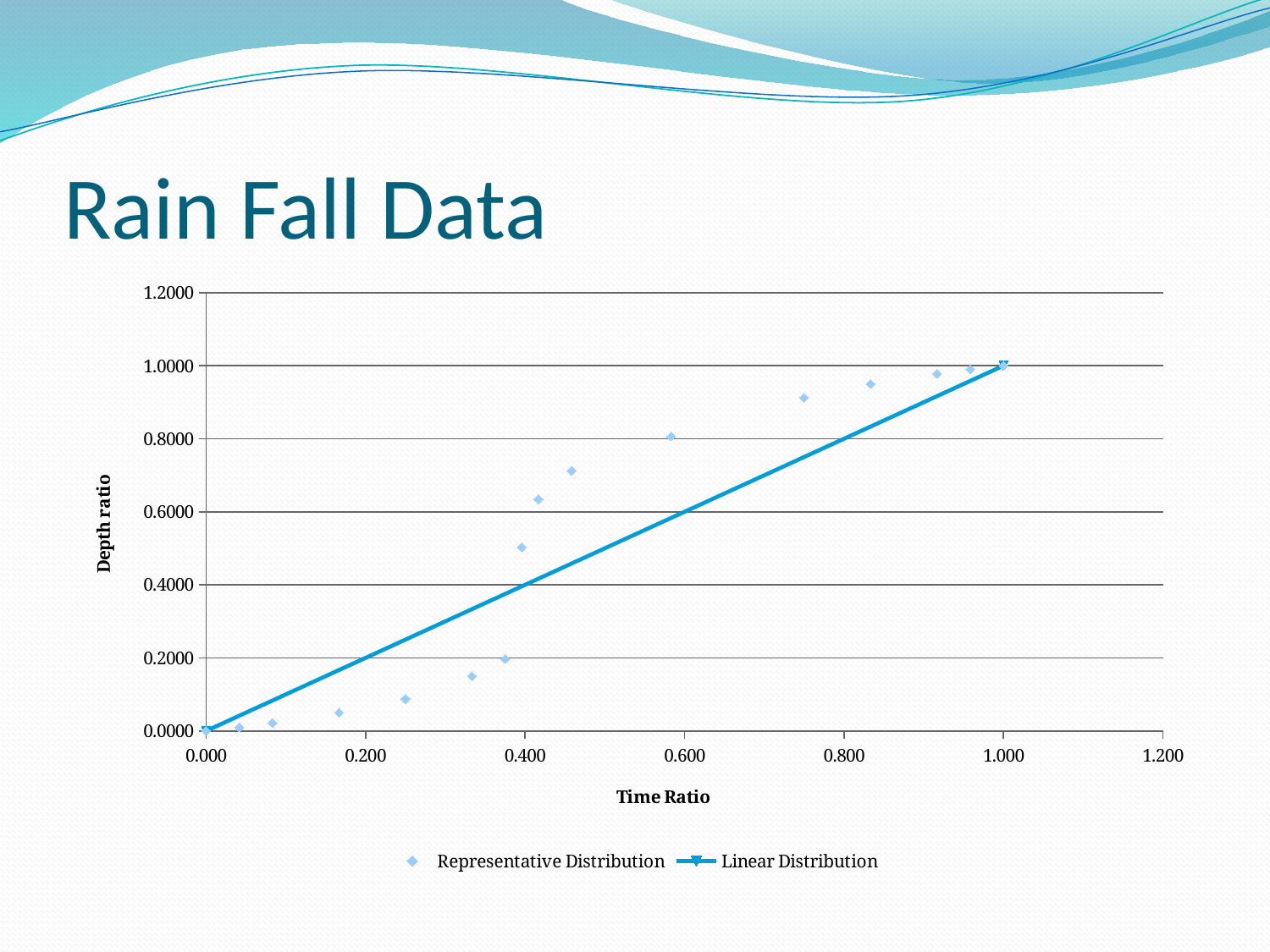
At a time ratio of 0.400, which series has the higher depth ratio, Representative Distribution or Linear Distribution? Representative Distribution Is the Representative Distribution depth ratio at a time ratio of about 0.750 greater or less than 0.8000? greater How many series does the legend list? 2 What are the two series named in the legend? Representative Distribution and Linear Distribution What is the title of the x axis? Time Ratio Do the Representative Distribution values rise or fall as the time ratio increases? Rise What kind of chart is shown on the slide? Scatter chart At a time ratio of 0.250, which series has the higher depth ratio, Representative Distribution or Linear Distribution? Linear Distribution What is the depth ratio of the Linear Distribution at a time ratio of 1.000? 1.0000 What is the depth ratio of the Linear Distribution at a time ratio of 0.000? 0.0000 Is the Representative Distribution depth ratio at a time ratio of about 0.250 greater or less than 0.2000? less Is the Representative Distribution depth ratio at a time ratio of about 0.458 greater or less than 0.6000? greater